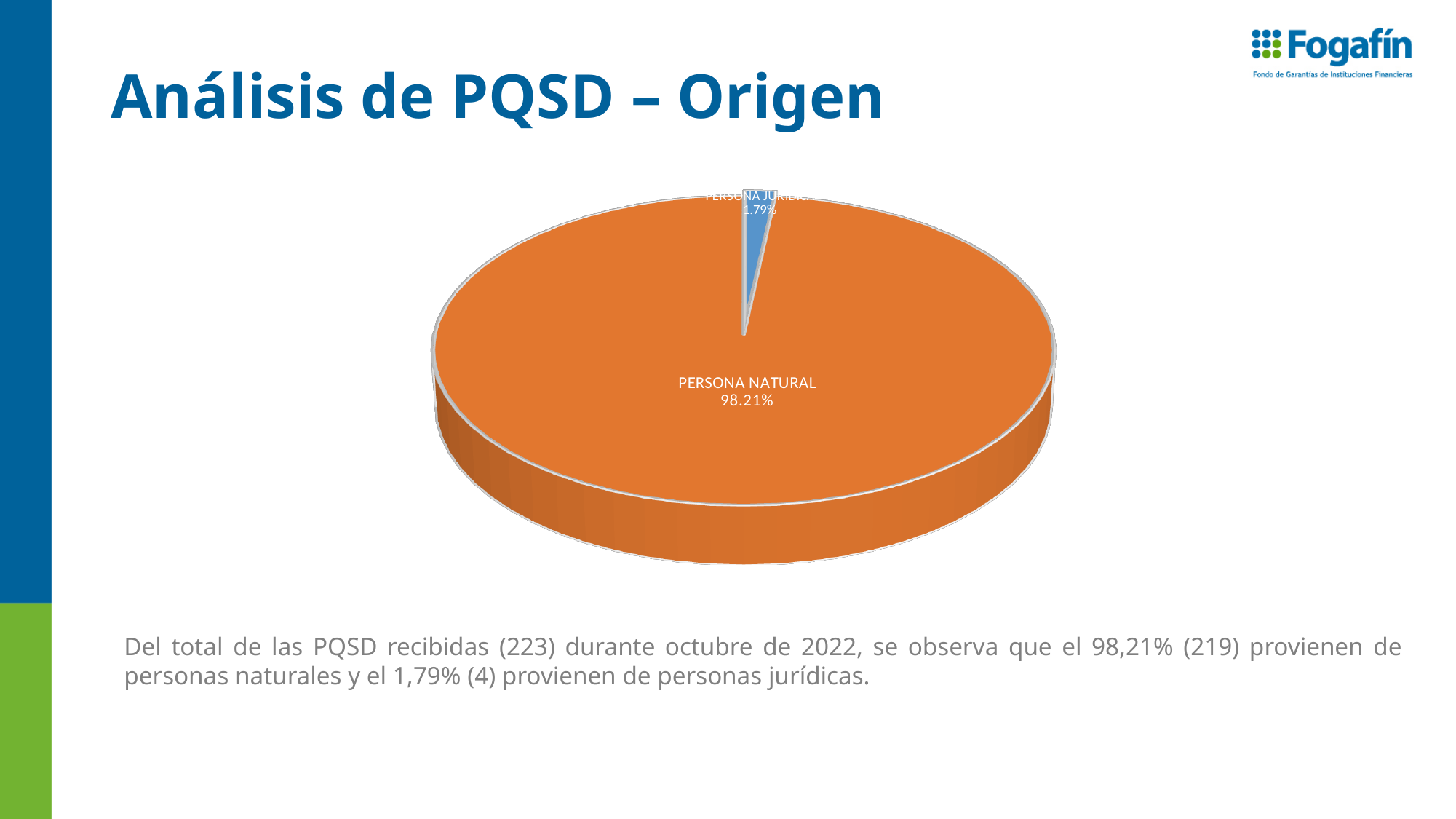
What is the difference in percentage points between the PERSONA NATURAL and PERSONA JURIDICA slices? 96.42% How many slices does the pie chart have? 2 What kind of chart is shown on the slide? Pie chart What colour is the PERSONA NATURAL slice? Orange Which slice is larger, PERSONA NATURAL or PERSONA JURIDICA? PERSONA NATURAL Which slice of the pie is the largest? PERSONA NATURAL What colour is the PERSONA JURIDICA slice? Blue Which slice of the pie is the smallest? PERSONA JURIDICA What share of the pie does PERSONA JURIDICA represent? 1.79% What share of the pie does PERSONA NATURAL represent? 98.21%